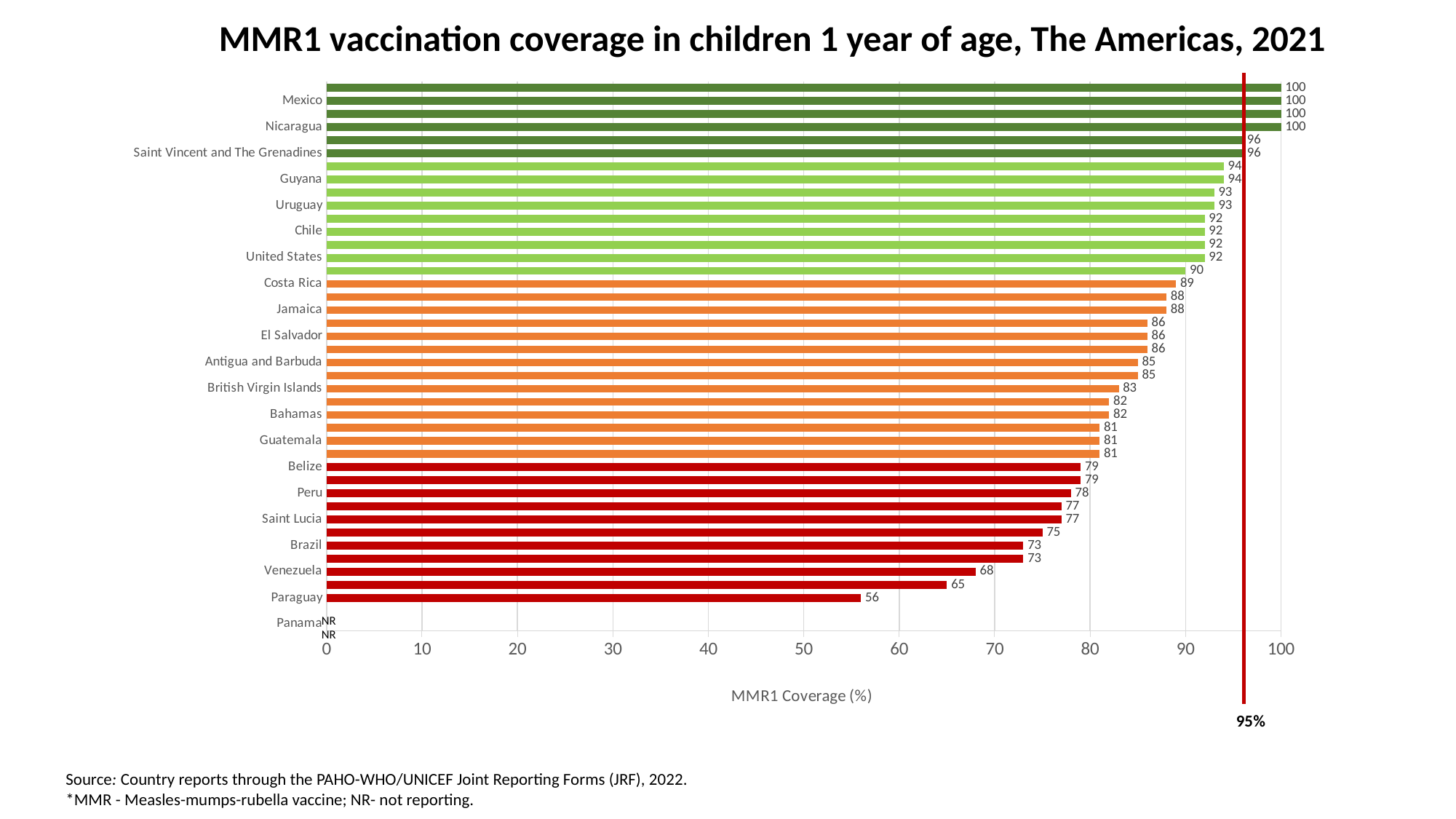
What is the MMR1 coverage value shown for Paraguay? 56 What threshold does the red vertical line on the chart mark? 95% Among the labelled countries, which has the lowest plotted coverage value? Paraguay Which has a lower MMR1 coverage value, Peru or Saint Lucia? Saint Lucia What value is shown for Panama? NR What is the difference between the values for Guyana and Venezuela? 26 What is the MMR1 coverage value shown for Mexico? 100 What is the MMR1 coverage value shown for Brazil? 73 Is the value for Bahamas greater or less than 90? less What is the MMR1 coverage value shown for Saint Vincent and The Grenadines? 96 Which has a higher MMR1 coverage value, Costa Rica or Jamaica? Costa Rica What kind of chart is shown on the slide? Bar chart